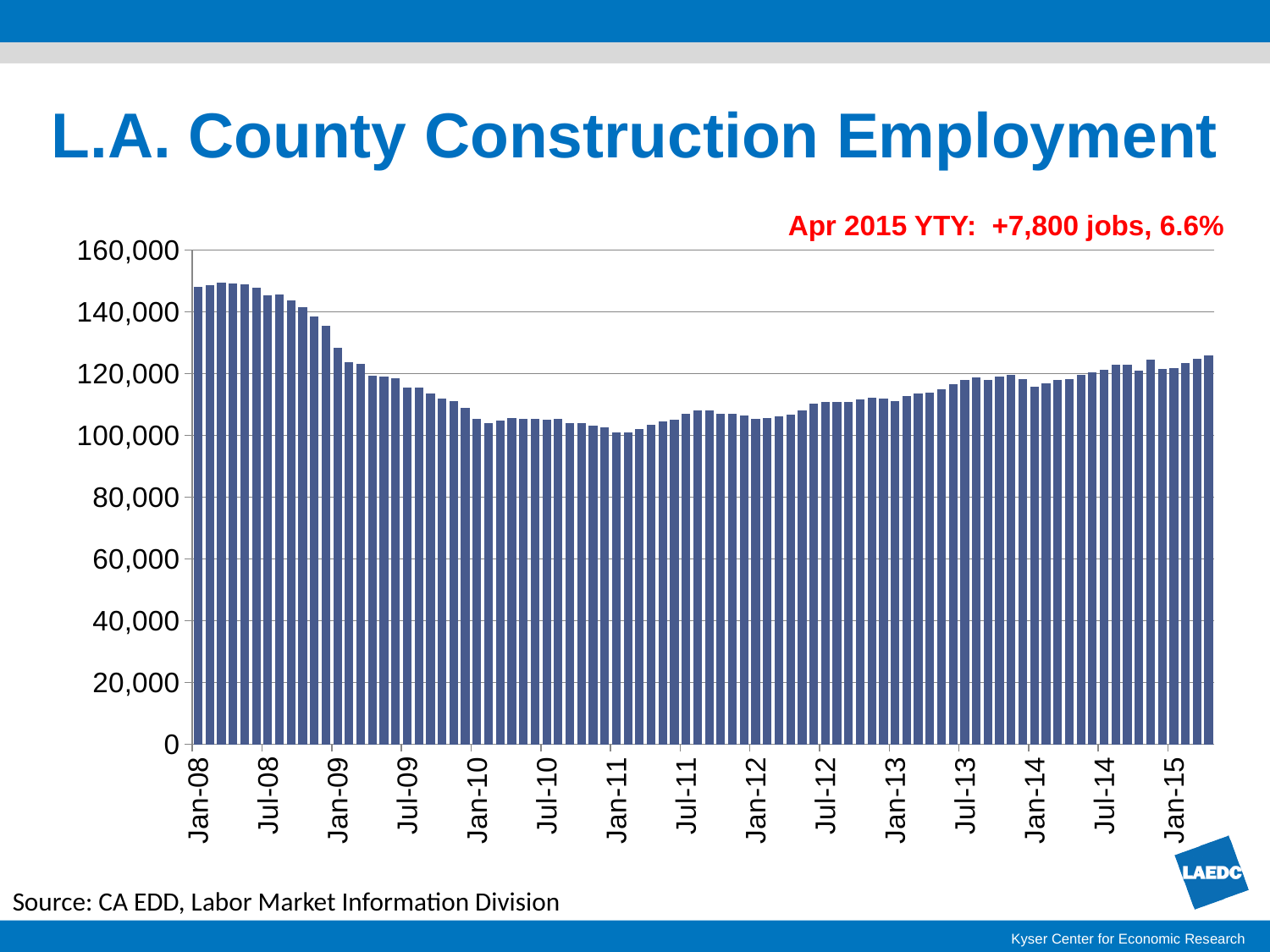
What type of chart is shown on the slide? bar chart Do the values rise or fall from Jan-08 to Jan-11? fall What is the title of the chart? L.A. County Construction Employment According to the annotation, what was the April 2015 year-to-year change in jobs? +7,800 jobs, 6.6% Is the value for Jan-09 greater or less than 120,000? greater Is the value for Jan-11 greater or less than 120,000? less Is the value for Jul-12 greater or less than 100,000? greater Do the values rise or fall from Jan-12 to Jan-15? rise How many tick labels are shown on the x axis? 15 Which is larger, the value for Jan-08 or the value for Jan-11? Jan-08